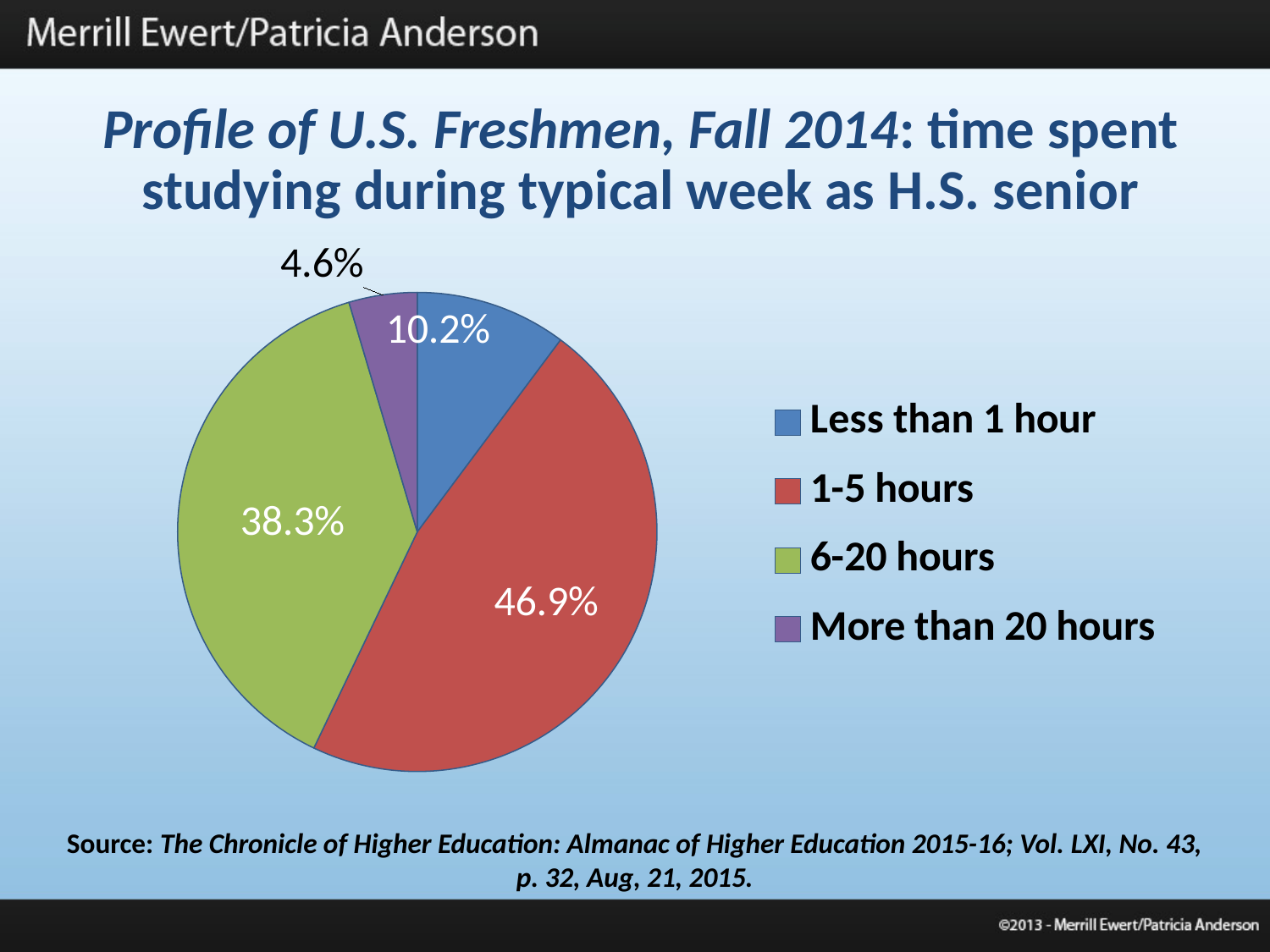
What is the combined share of the 'Less than 1 hour' and 'More than 20 hours' slices? 14.8% What percentage is shown for the 'Less than 1 hour' slice? 10.2% Which slice is larger: 'Less than 1 hour' or 'More than 20 hours'? Less than 1 hour Which category has the smallest slice of the pie? More than 20 hours What is the difference in percentage points between the '1-5 hours' slice and the '6-20 hours' slice? 8.6 What percentage is shown for the 'More than 20 hours' slice? 4.6% What share of the pie is labelled for the '1-5 hours' slice? 46.9% What colour is the slice for '6-20 hours'? Green How many categories does the pie chart show? 4 What kind of chart is shown on the slide? Pie chart Which category has the largest slice of the pie? 1-5 hours What percentage is shown for the '6-20 hours' slice? 38.3%